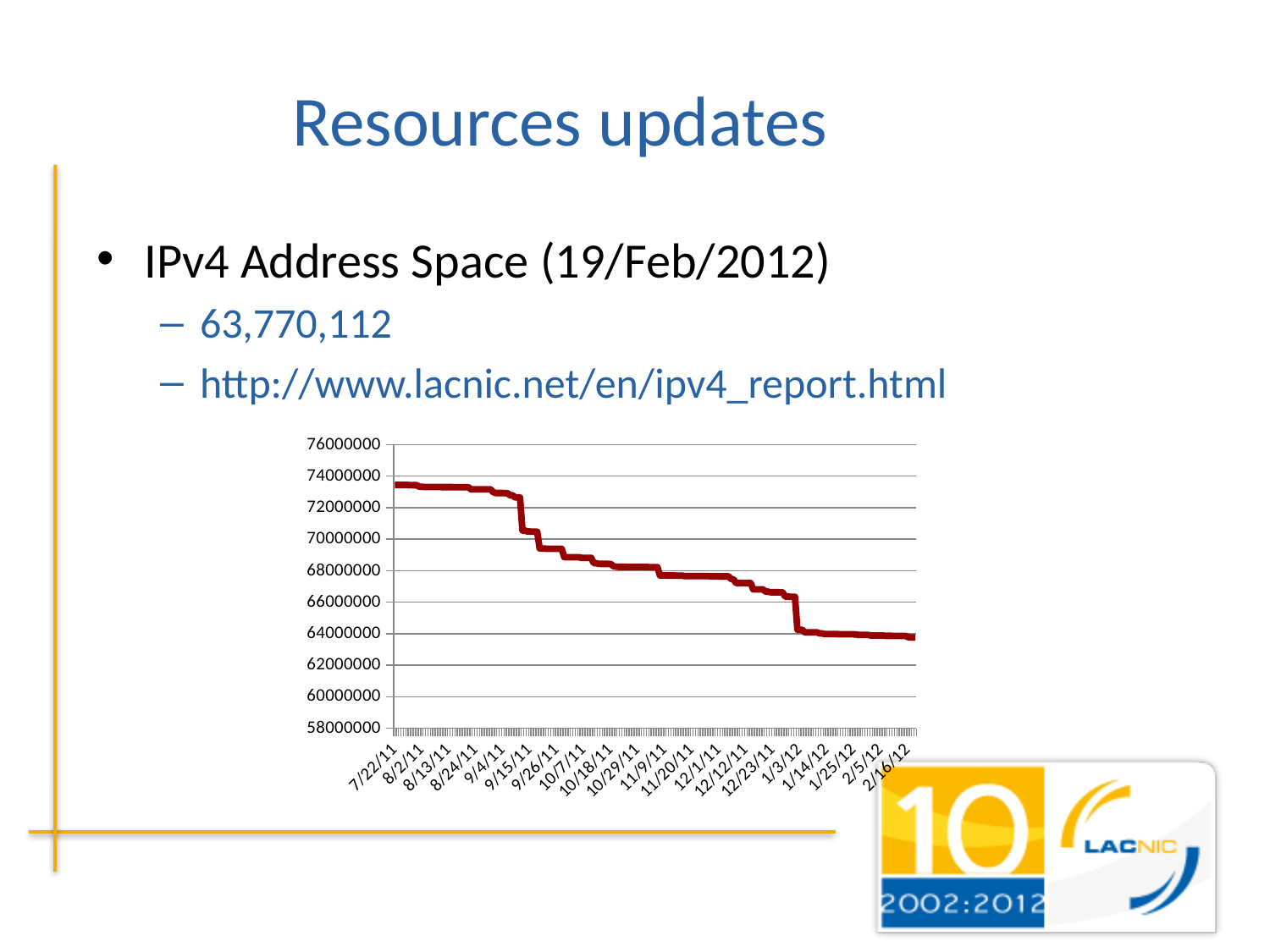
What kind of chart is shown on the slide? line chart Is the value at 2/16/12 greater or less than 66000000? less Is the value at 9/4/11 greater or less than 72000000? greater Which date has the larger value, 10/7/11 or 1/14/12? 10/7/11 What is the first date label on the chart's x axis? 7/22/11 Is the value at 12/12/11 greater or less than 66000000? greater Do the values in the chart rise or fall from 7/22/11 to 2/16/12? fall What is the highest value shown on the chart's y axis? 76000000 How many date labels are shown along the x axis of the chart? 20 Which date has the larger value, 7/22/11 or 2/16/12? 7/22/11